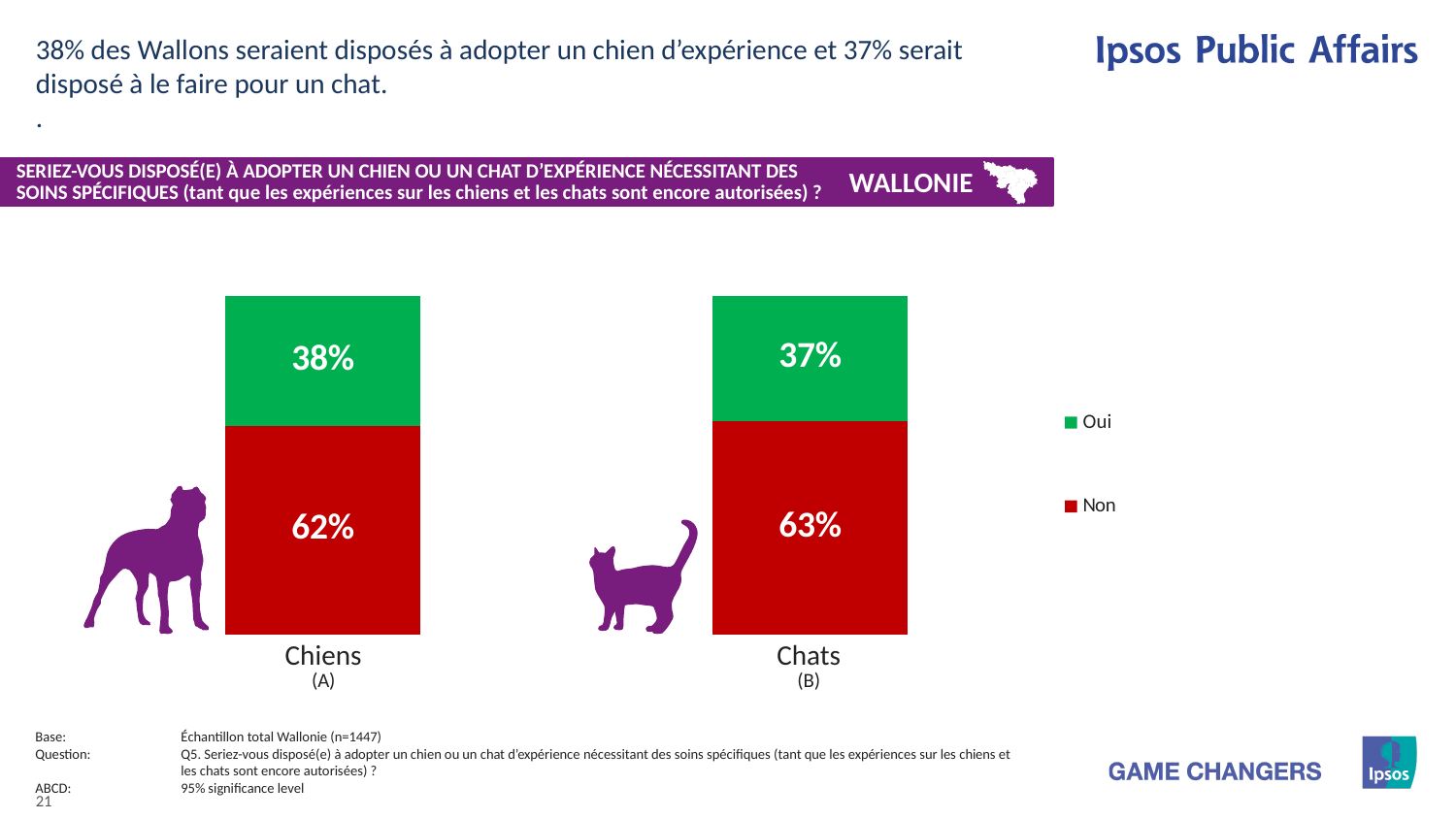
How many categories are shown on the x axis of the chart? 2 What is the total of the stacked bar for Chats? 100% How many series does the legend list? 2 Which category has the higher 'Non' share, Chiens or Chats? Chats What is the difference between the 'Non' share for Chats and the 'Non' share for Chiens? 1% What percentage of respondents answered 'Oui' for Chats? 37% What percentage of respondents answered 'Oui' for Chiens? 38% Which category has the higher 'Oui' share, Chiens or Chats? Chiens What is the difference between the 'Oui' and 'Non' shares for Chiens? 24% What kind of chart is shown on the slide? Stacked bar chart What percentage of respondents answered 'Non' for Chiens? 62% What percentage of respondents answered 'Non' for Chats? 63%